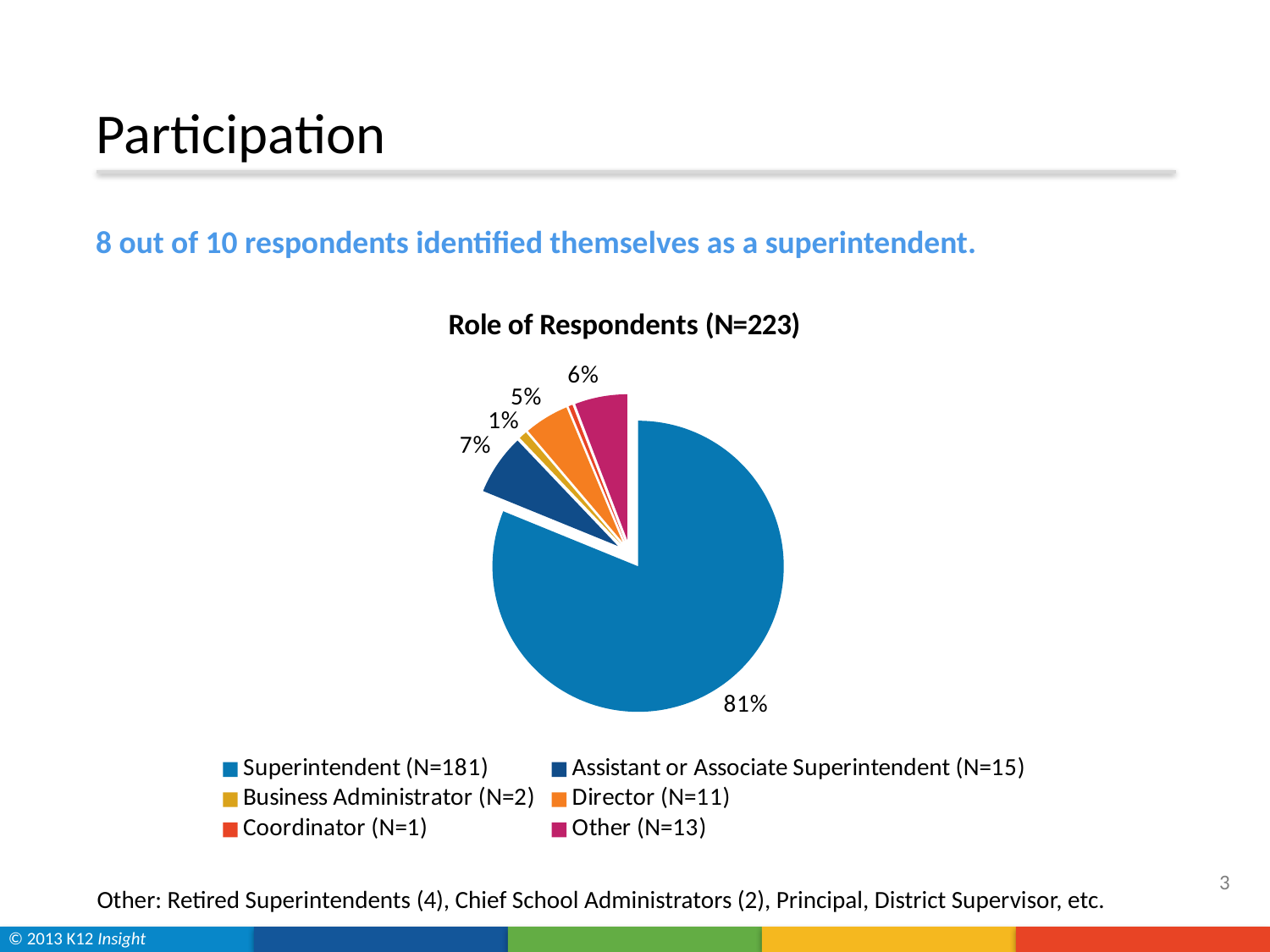
Which role has the fewest respondents according to the legend? Coordinator (N=1) What percentage of respondents fall into the Other category? 6% What percentage of respondents identified as Business Administrator? 1% What is the title of the chart? Role of Respondents (N=223) What is the difference in percentage points between the Superintendent share and the Assistant or Associate Superintendent share? 74 What percentage of respondents identified as Director? 5% Which has a larger share of respondents, Director or Other? Other What percentage of respondents identified as Assistant or Associate Superintendent? 7% What percentage of respondents identified as Superintendent? 81% How many role categories does the legend list? 6 Which role has the largest share of respondents? Superintendent What type of chart is shown on the slide? pie chart